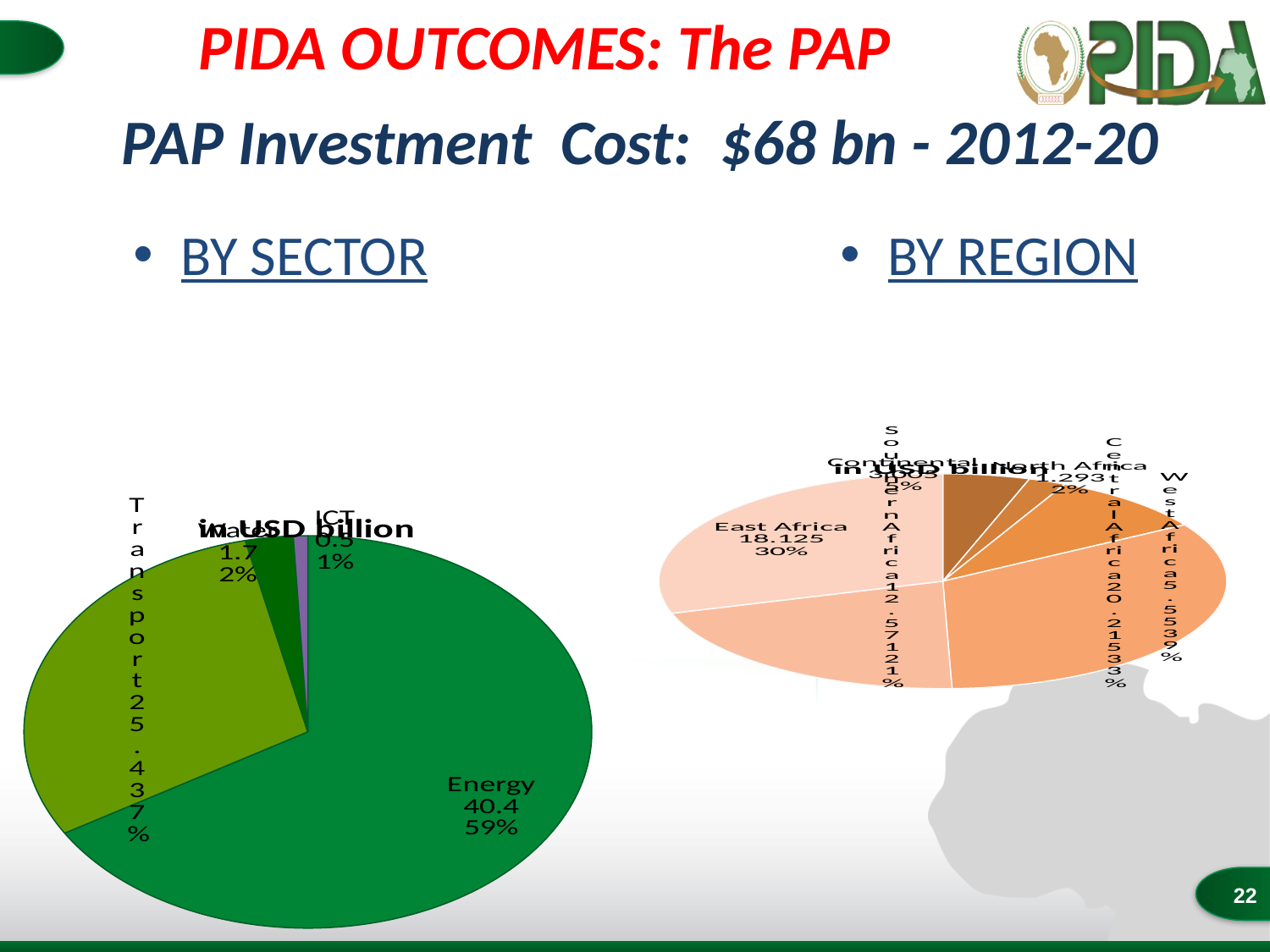
In the BY SECTOR chart, what share of the pie does Transport take? 37% In the BY REGION chart, which is larger, East Africa or West Africa? East Africa How many sectors are shown in the BY SECTOR chart? 4 In the BY REGION chart, what share of the pie does North Africa take? 2% In the BY REGION chart, what share of the pie does East Africa take? 30% In the BY REGION chart, what is the value for East Africa? 18.125 In the BY SECTOR chart, what is the difference between the Energy value and the Transport value? 15 What kind of chart is the BY SECTOR chart on the left? pie chart In the BY SECTOR chart, which sector has the smallest slice? ICT In the BY SECTOR chart, what is the value for Energy? 40.4 In the BY SECTOR chart, which sector has the largest slice? Energy